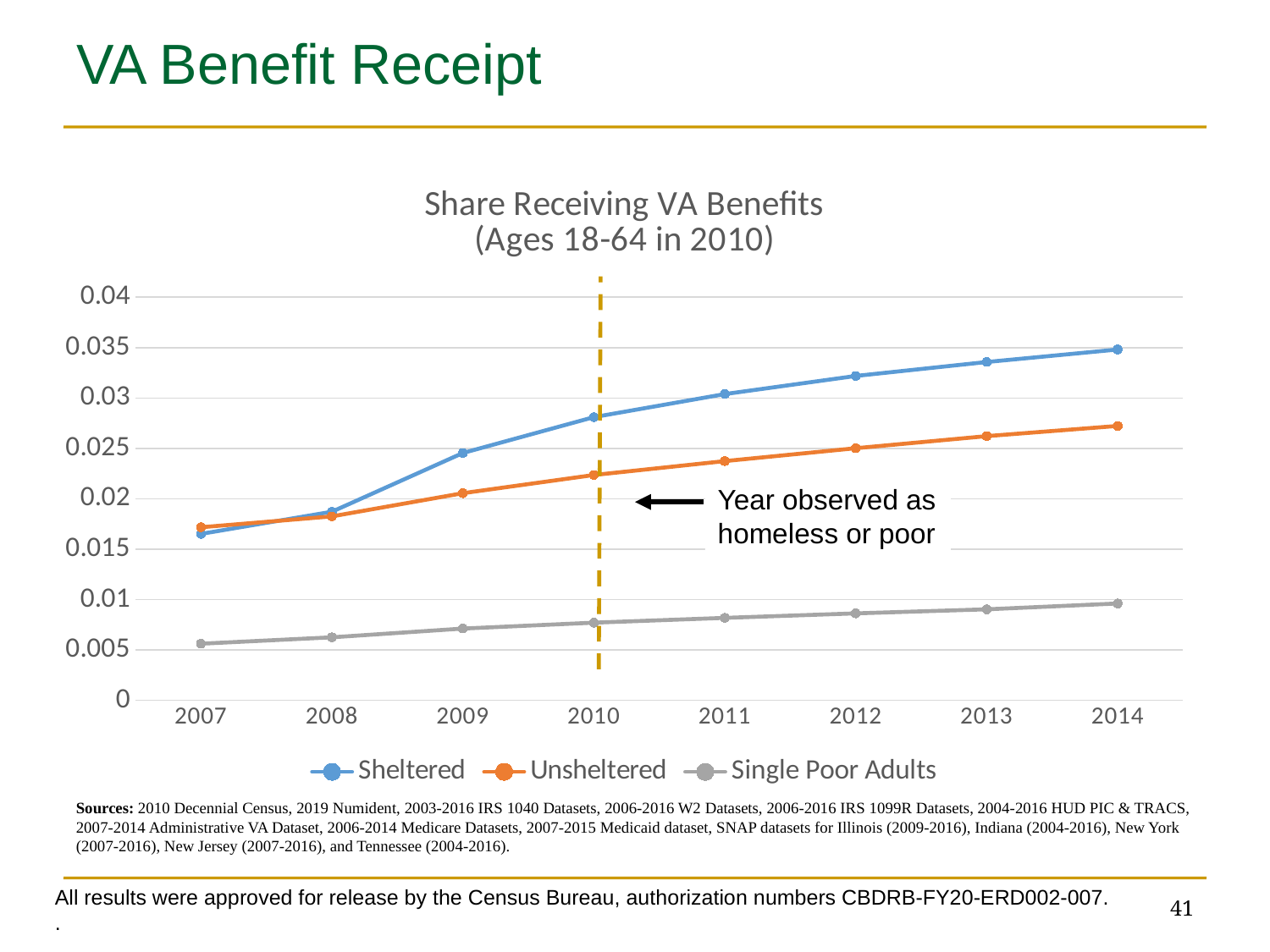
Which series has the highest value in 2014? Sheltered Is the Unsheltered value for 2010 greater or less than 0.025? less Is the Sheltered value for 2014 greater or less than 0.03? greater What is the title of the chart? Share Receiving VA Benefits (Ages 18-64 in 2010) Do the Sheltered values rise or fall from 2007 to 2014? rise How many years are plotted along the x axis? 8 Which series has the lowest value in 2012? Single Poor Adults How many series does the legend list? 3 In 2014, which is larger: the Sheltered value or the Unsheltered value? Sheltered What kind of chart is shown on the slide? line chart Is the Sheltered value for 2007 greater or less than 0.02? less